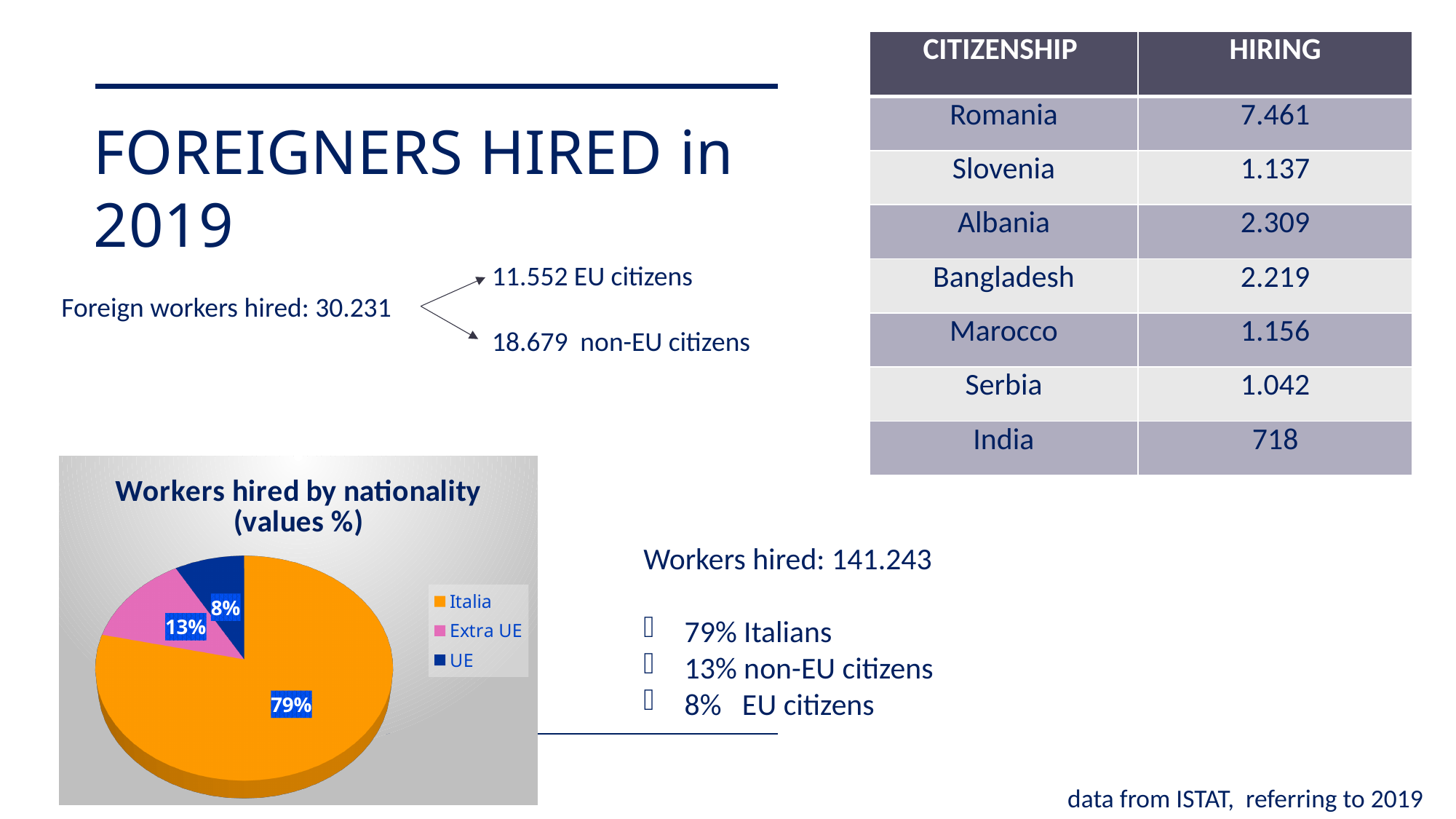
What is the title of the pie chart? Workers hired by nationality (values %) What is the value for Italia in the pie chart? 79% What is the value for Extra UE in the pie chart? 13% What colour is the Italia slice in the pie chart? orange What kind of chart is 'Workers hired by nationality (values %)'? pie chart What is the value for UE in the pie chart? 8% What is the difference between the Italia and Extra UE slices in the pie chart? 66% What is the difference between the Extra UE and UE slices in the pie chart? 5% How many slices does the pie chart have? 3 Which category has the smallest slice in the pie chart? UE Which category has the largest slice in the pie chart? Italia Which is larger in the pie chart, Extra UE or UE? Extra UE